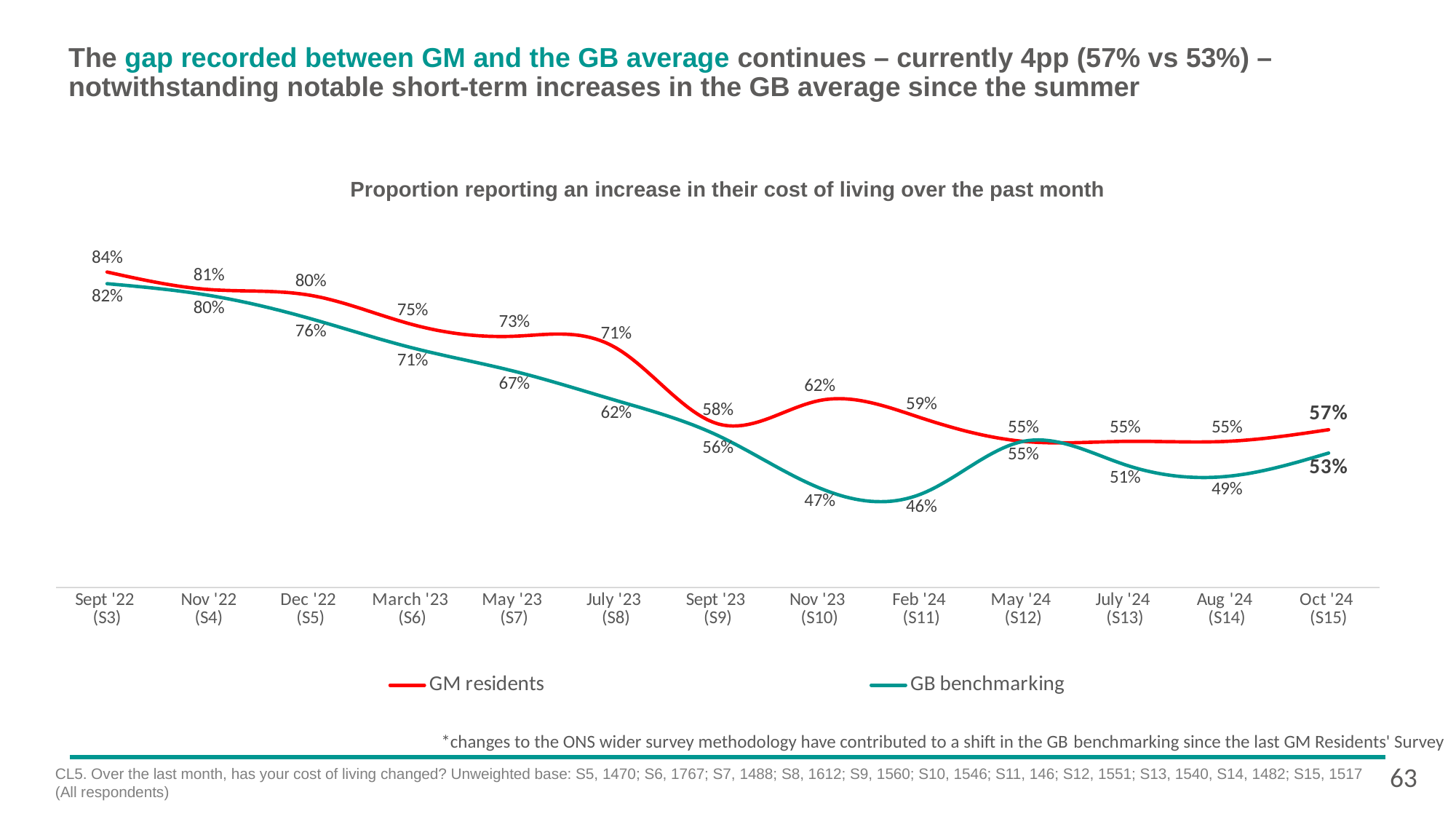
At which time point is the GM residents value highest? Sept '22 (S3) In Nov '23 (S10), which series has the larger value, GM residents or GB benchmarking? GM residents What kind of chart is shown on the slide? Line chart How many series does the legend list? 2 How many time points are plotted along the x axis? 13 Overall, do the GM residents values rise or fall from Sept '22 to Oct '24? Fall At which time point is the GB benchmarking value lowest? Feb '24 (S11) What is the value for GM residents in Sept '22 (S3)? 84% What is the value for GB benchmarking in Feb '24 (S11)? 46% What is the value for GM residents in Nov '23 (S10)? 62% What is the title of the chart? Proportion reporting an increase in their cost of living over the past month What is the difference between GM residents and GB benchmarking in Oct '24 (S15)? 4pp